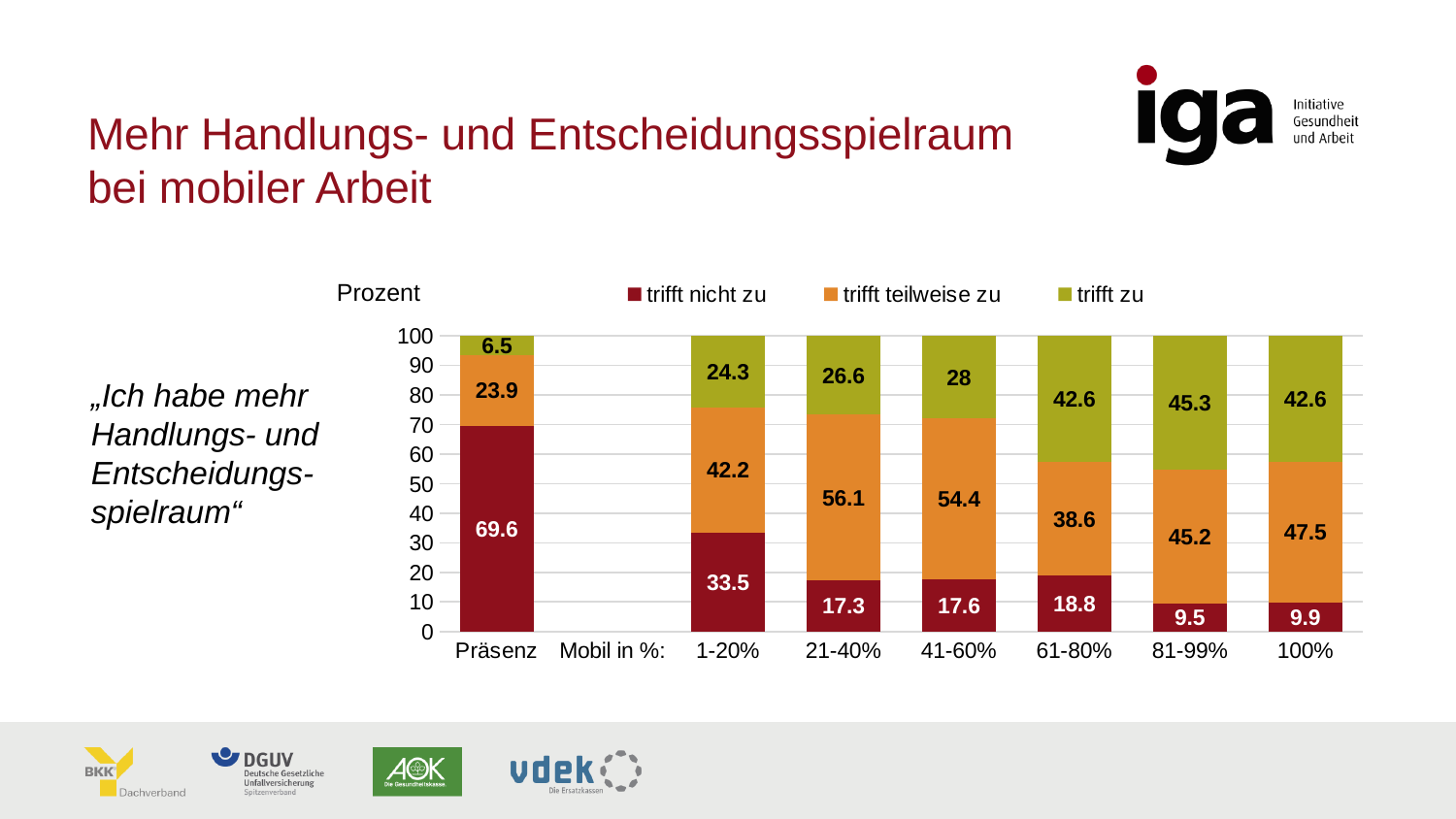
Which category has the lowest value for "trifft nicht zu"? 81-99% What is the value of "trifft nicht zu" for Präsenz? 69.6 What is the label on the vertical axis of the chart? Prozent Is the "trifft zu" value larger for 61-80% or for 1-20%? 61-80% What kind of chart is shown on the slide? Stacked bar chart What is the difference between the "trifft nicht zu" values for Präsenz and 1-20%? 36.1 Which category has the highest value for "trifft teilweise zu"? 21-40% How many series does the legend list? 3 What is the value of "trifft teilweise zu" for the 21-40% category? 56.1 What is the value of "trifft zu" for the 81-99% category? 45.3 Which category has the highest value for "trifft nicht zu"? Präsenz What is the total of the stacked bar for Präsenz? 100